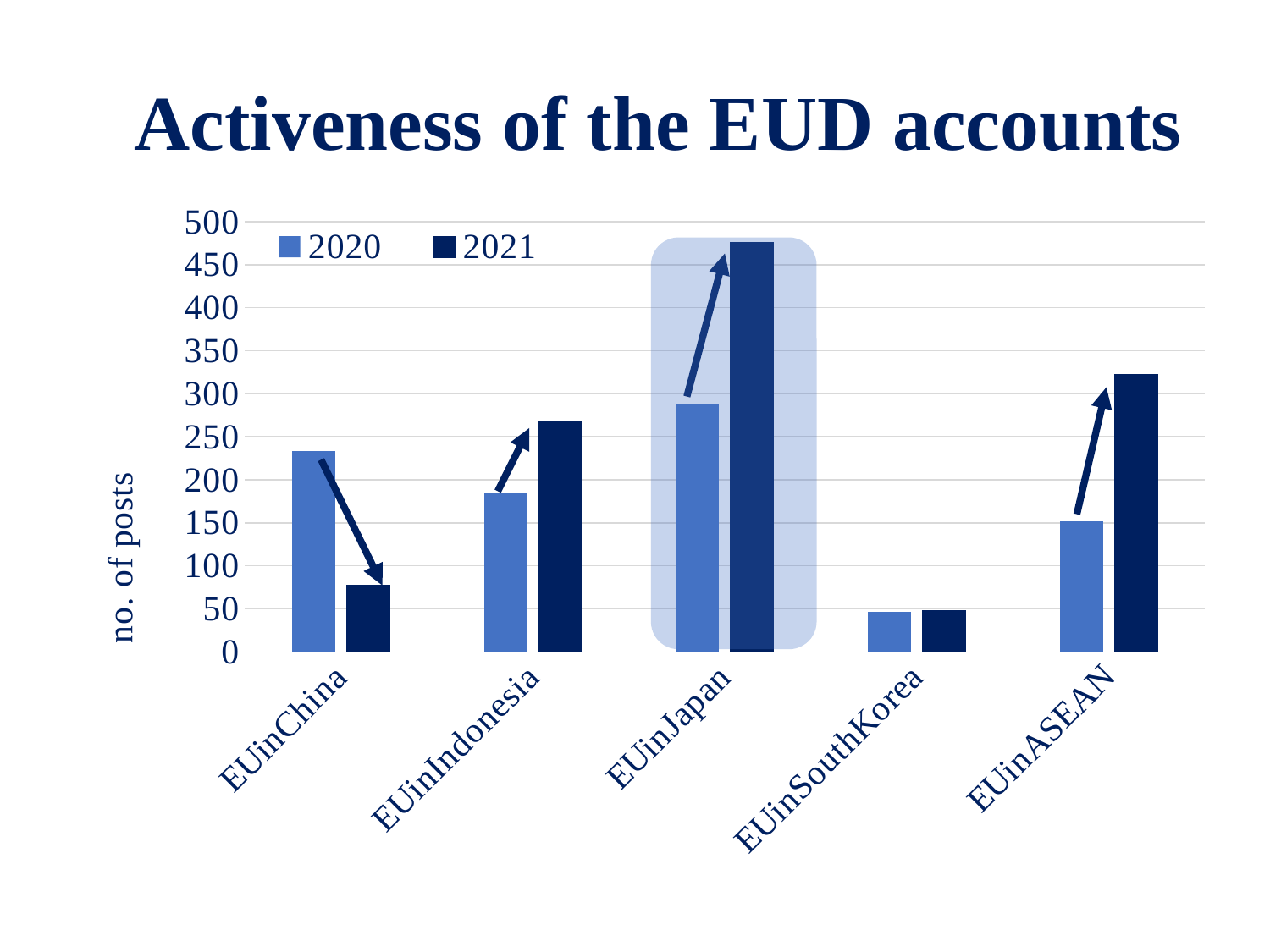
Which account has the highest number of posts in 2020? EUinJapan For EUinChina, which year has more posts, 2020 or 2021? 2020 Is the 2021 value for EUinChina greater or less than 100? less Which account has the highest number of posts in 2021? EUinJapan What kind of chart is shown on the slide? bar chart What is the title of the chart? Activeness of the EUD accounts Which has more posts in 2021, EUinIndonesia or EUinASEAN? EUinASEAN Which account has the lowest number of posts in 2020? EUinSouthKorea Is the 2021 value for EUinJapan greater or less than 450? greater Is the 2021 value for EUinASEAN greater or less than 300? greater How many accounts (categories) are shown on the x axis? 5 How many series does the legend list? 2